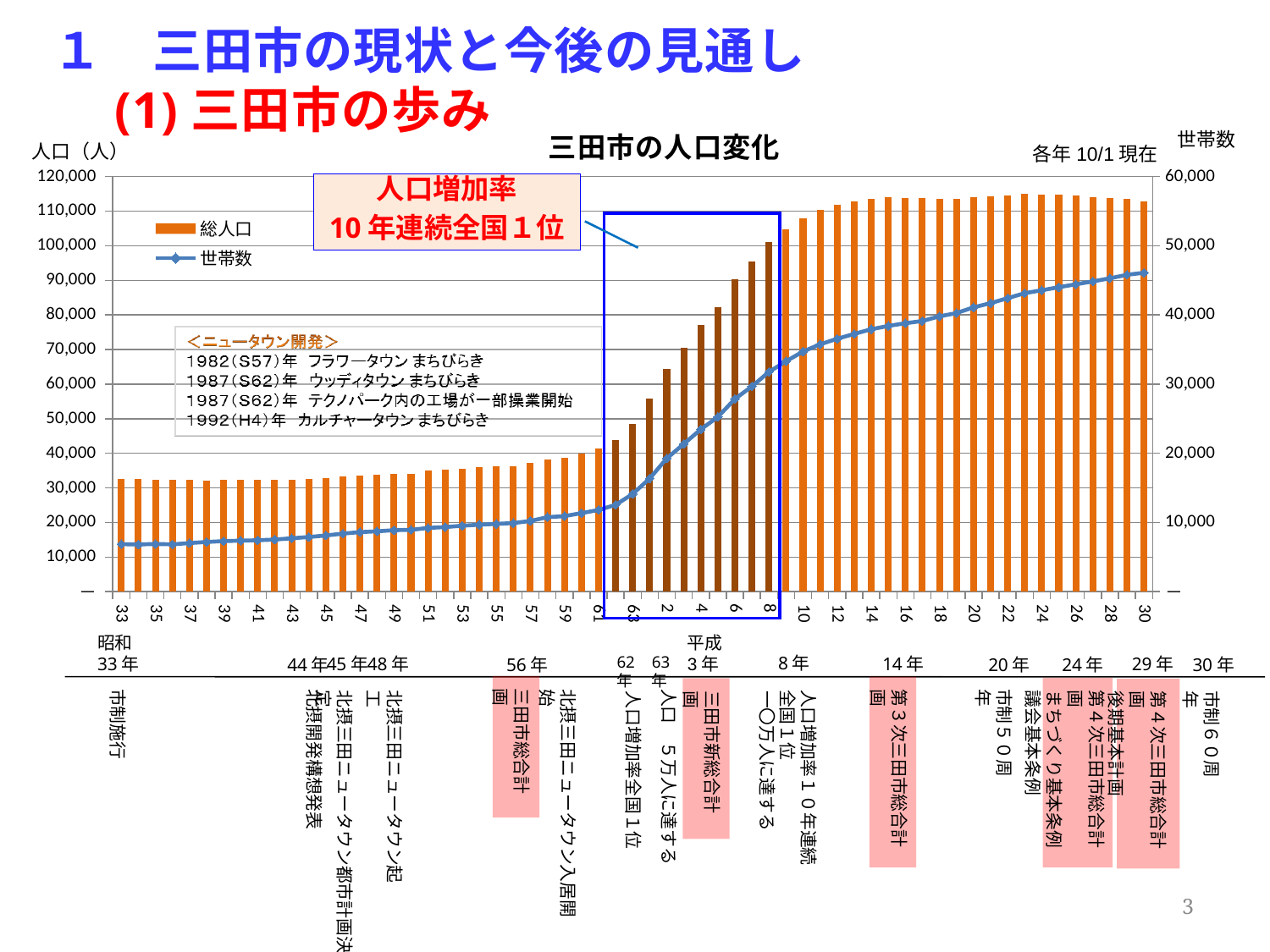
Which has the larger 総人口 value, 昭和61年 or 平成8年? 平成8年 Is the 世帯数 value for 昭和33年 greater or less than 10,000 on the right axis? less What is the title of the chart? 三田市の人口変化 What are the two series named in the legend? 総人口 and 世帯数 Does 総人口 rise or fall from 昭和61年 to 平成10年? rise Does the 世帯数 line rise or fall from 昭和33年 to 平成30年? rise What kind of chart is used to show 総人口? bar chart Is the 総人口 value for 平成30年 greater or less than 100,000? greater How many series does the legend list? 2 Is the 総人口 value for 平成10年 greater or less than 100,000? greater